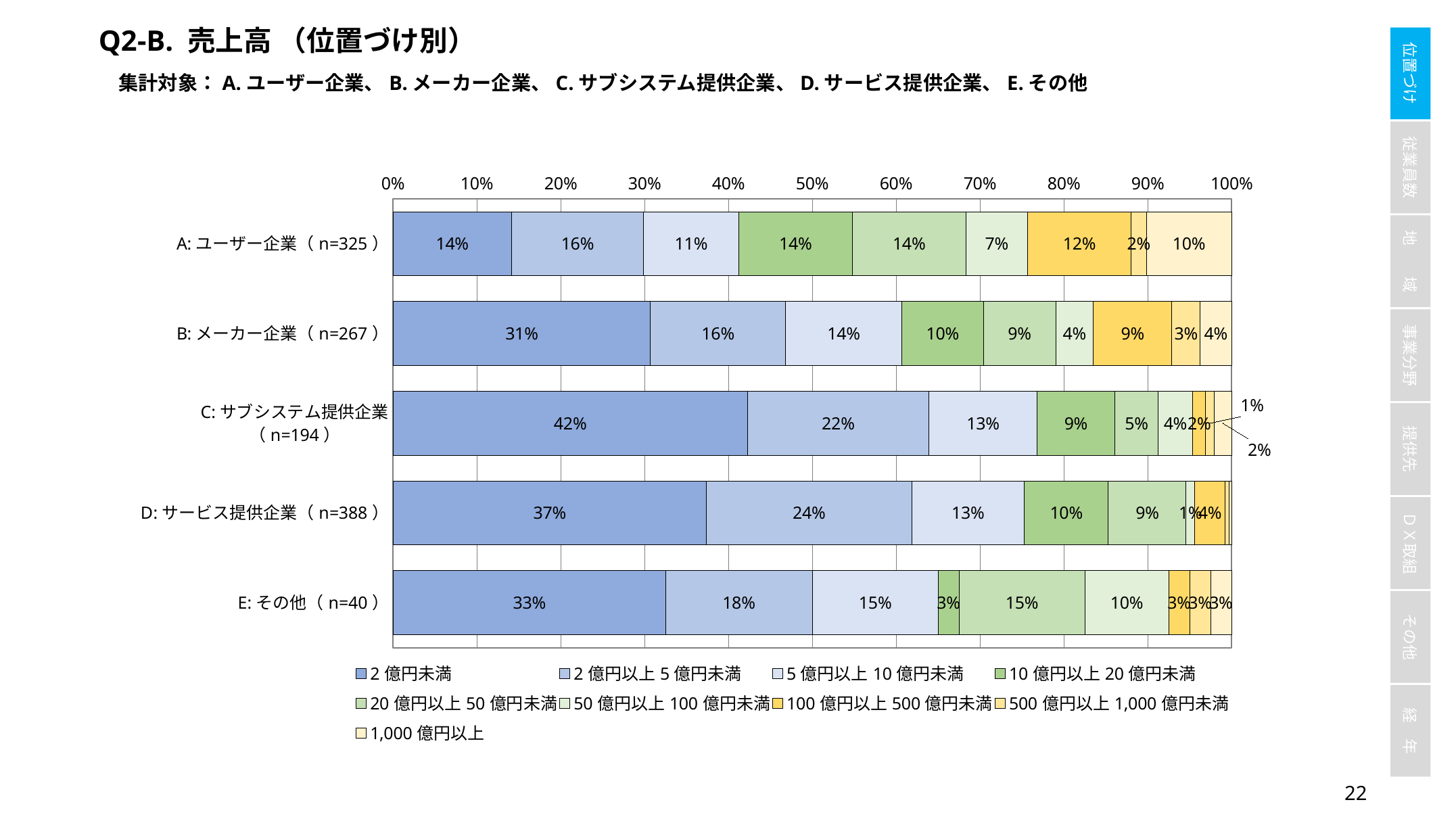
What is the value for 20 億円以上 50 億円未満 in the E: その他 bar? 15% Which category has the highest share of 2 億円未満? C: サブシステム提供企業 What is the value for 1,000 億円以上 in the A: ユーザー企業 bar? 10% What kind of chart is shown on the slide? Stacked bar chart What is the value for 2 億円以上 5 億円未満 in the B: メーカー企業 bar? 16% Which category has the lowest share of 2 億円未満? A: ユーザー企業 What is the value for 2 億円未満 in the A: ユーザー企業 bar? 14% How many categories (bars) are shown in the chart? 5 What is the difference between the 2 億円未満 share for C: サブシステム提供企業 and for A: ユーザー企業? 28 percentage points How many series does the legend list? 9 Which has the larger 2 億円以上 5 億円未満 share, D: サービス提供企業 or E: その他? D: サービス提供企業 What is the value for 2 億円未満 in the C: サブシステム提供企業 bar? 42%